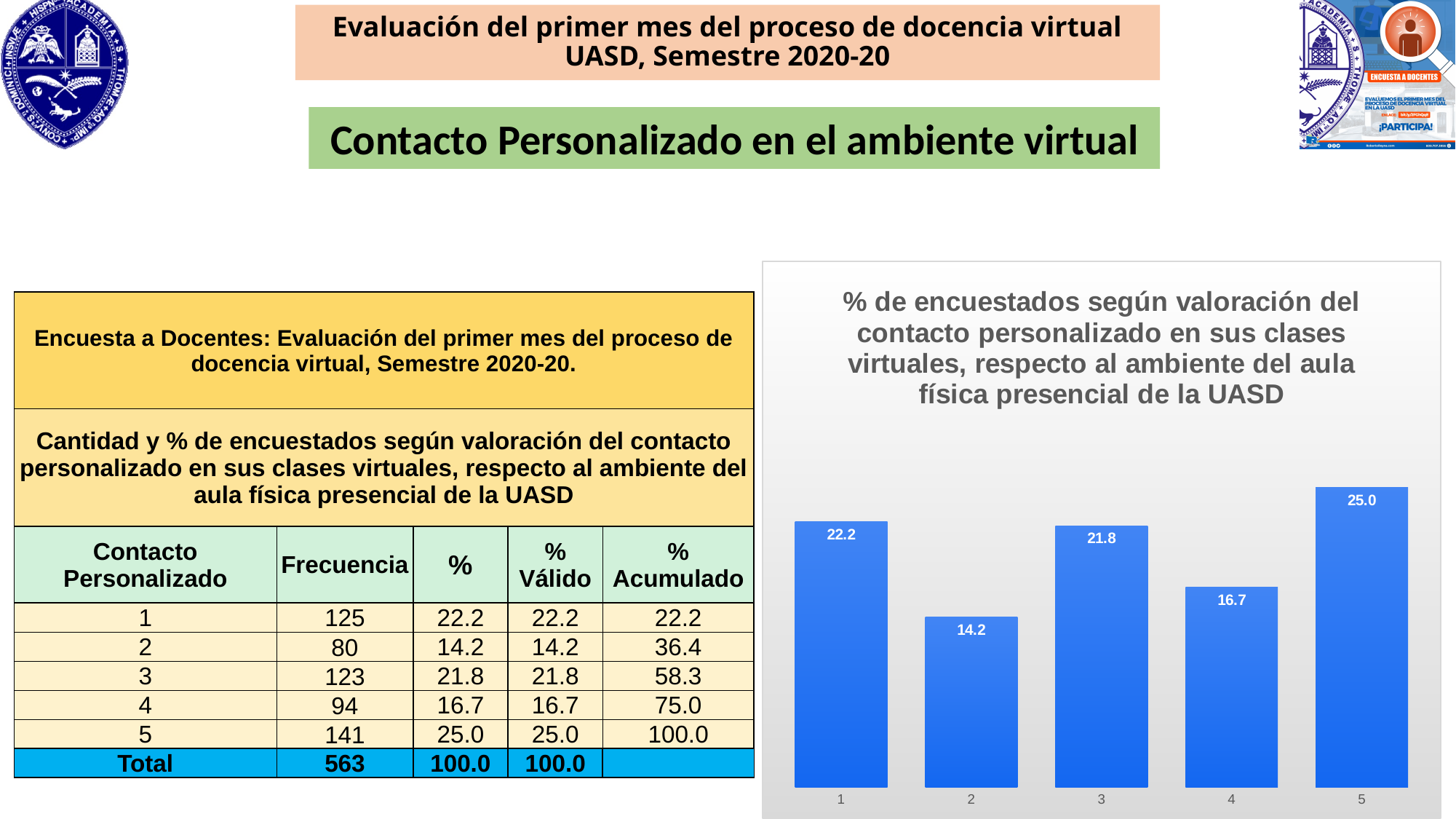
What is the value for category 2 in the bar chart? 14.2 What is the difference between the values for category 1 and category 3 in the bar chart? 0.4 Which is larger in the bar chart, the value for category 3 or the value for category 4? 3 How many bars are shown in the bar chart? 5 Which category has the highest value in the bar chart? 5 What is the title of the chart on the slide? % de encuestados según valoración del contacto personalizado en sus clases virtuales, respecto al ambiente del aula física presencial de la UASD Which category has the lowest value in the bar chart? 2 What colour are the bars in the chart? blue What kind of chart is shown on the slide? bar chart What is the value for category 1 in the bar chart? 22.2 What is the value for category 4 in the bar chart? 16.7 What is the difference between the values for category 5 and category 2 in the bar chart? 10.8